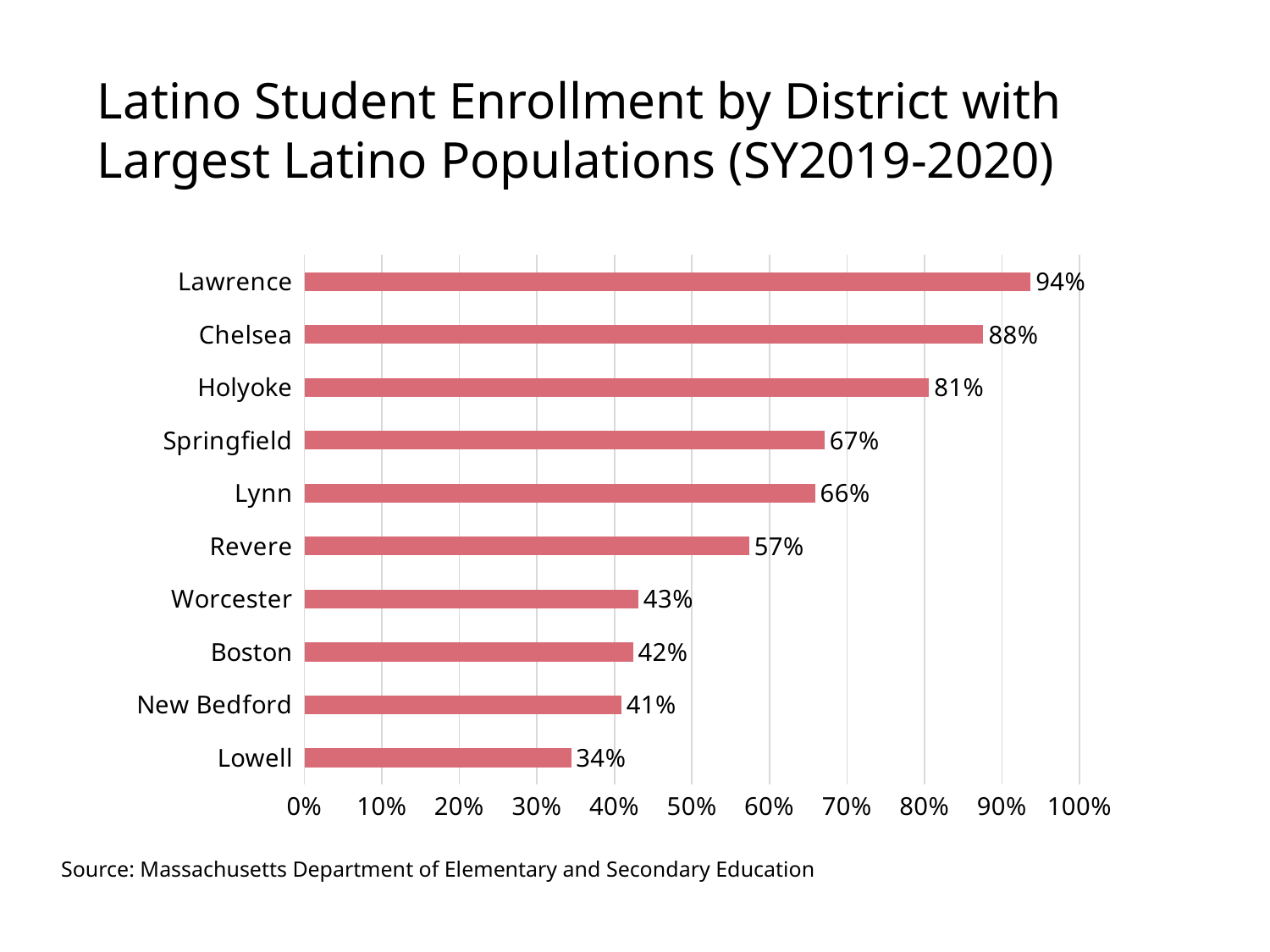
What source is cited for the chart data? Massachusetts Department of Elementary and Secondary Education What is the Latino student enrollment percentage for Worcester? 43% What kind of chart is shown on the slide? Bar chart What is the Latino student enrollment percentage for Lawrence? 94% Which district has the lowest Latino student enrollment percentage? Lowell Is the value for Lynn greater or less than 50%? greater What is the difference in percentage points between Springfield and Lowell? 33 What is the difference in percentage points between Chelsea and Holyoke? 7 Which district has the highest Latino student enrollment percentage? Lawrence What is the Latino student enrollment percentage for New Bedford? 41% How many districts are shown in the chart? 10 Which district has a higher Latino student enrollment percentage, Revere or Boston? Revere